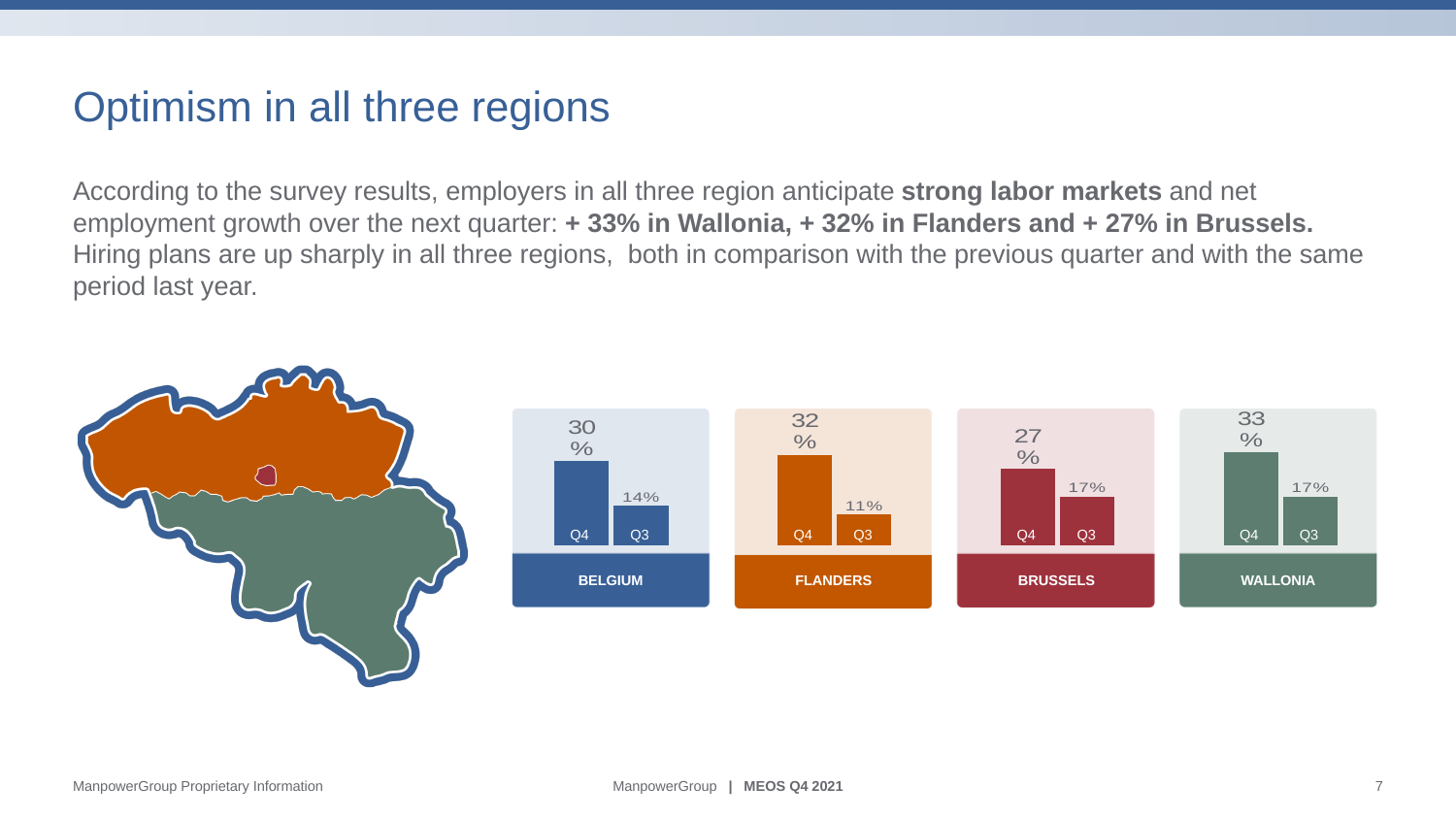
In the BELGIUM chart, what is the value for Q3? 14% In the BRUSSELS chart, which is larger, Q4 or Q3? Q4 In the FLANDERS chart, what is the value for Q3? 11% In the WALLONIA chart, what is the value for Q4? 33% In the BELGIUM chart, which category has the lowest value? Q3 What kind of chart is the FLANDERS chart? bar chart In the BRUSSELS chart, what is the value for Q4? 27% In the BELGIUM chart, what is the value for Q4? 30% In the WALLONIA chart, what is the difference between the Q4 and Q3 values? 16% In the FLANDERS chart, what is the difference between the Q4 and Q3 values? 21% How many charts are shown on the slide? 4 How many bars are in the WALLONIA chart? 2